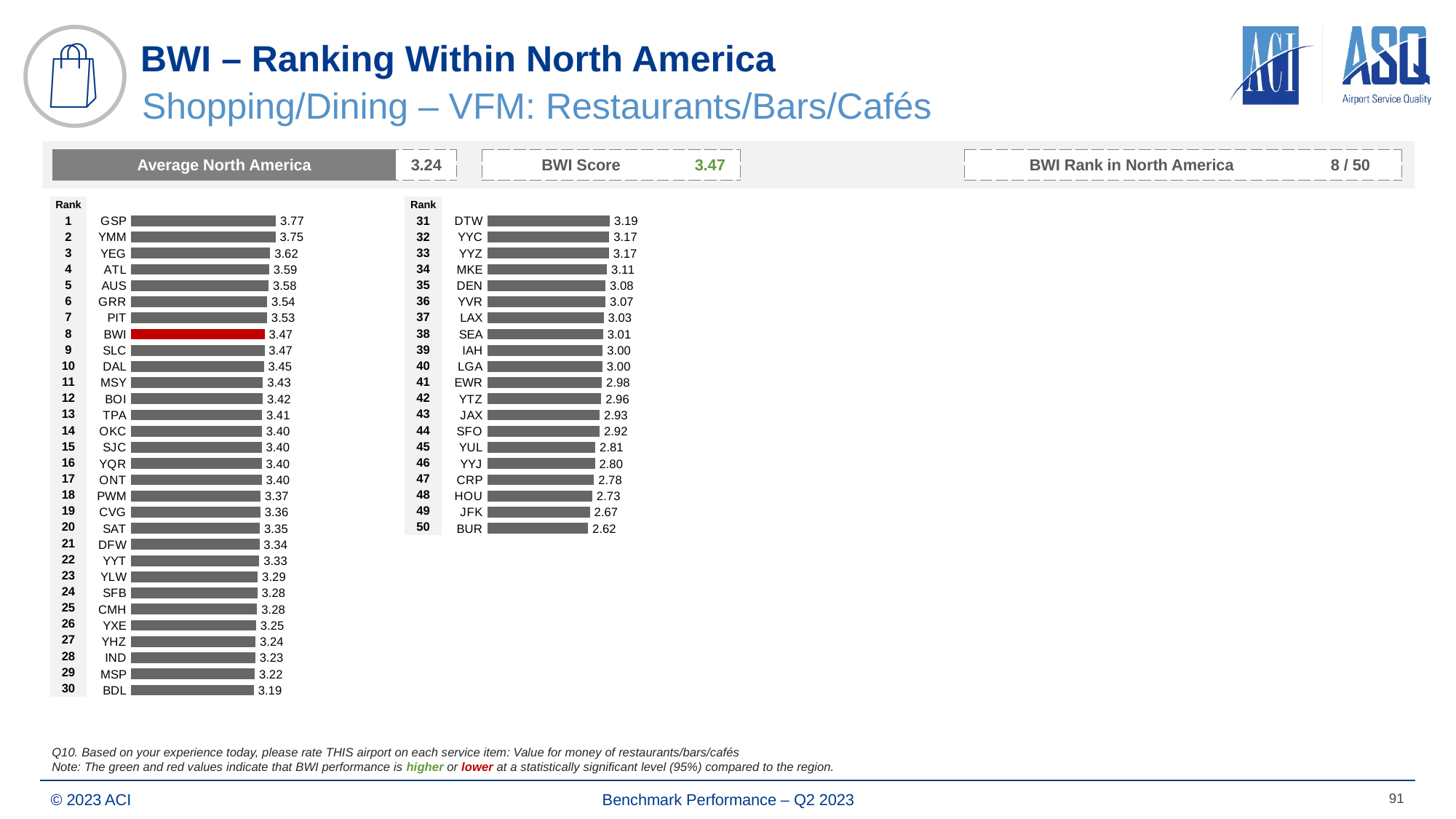
In the right chart (ranks 31–50), what is the score for LAX? 3.03 How many airports are shown in the right chart (ranks 31–50)? 20 In the left chart (ranks 1–30), what is the score for GSP? 3.77 In the right chart (ranks 31–50), what is the difference between the scores of DTW and BUR? 0.57 In the left chart (ranks 1–30), what is the difference between the scores of GSP and BDL? 0.58 What type of chart is used to show the airport rankings on this slide? Bar chart In the left chart (ranks 1–30), which airport has the highest score? GSP In the right chart (ranks 31–50), which airport has the lowest score? BUR How many airports are shown in the left chart (ranks 1–30)? 30 Which has the higher score, ATL in the left chart or DEN in the right chart? ATL In the left chart (ranks 1–30), what is the score for BWI? 3.47 In the left chart (ranks 1–30), which airport's bar is highlighted in red? BWI